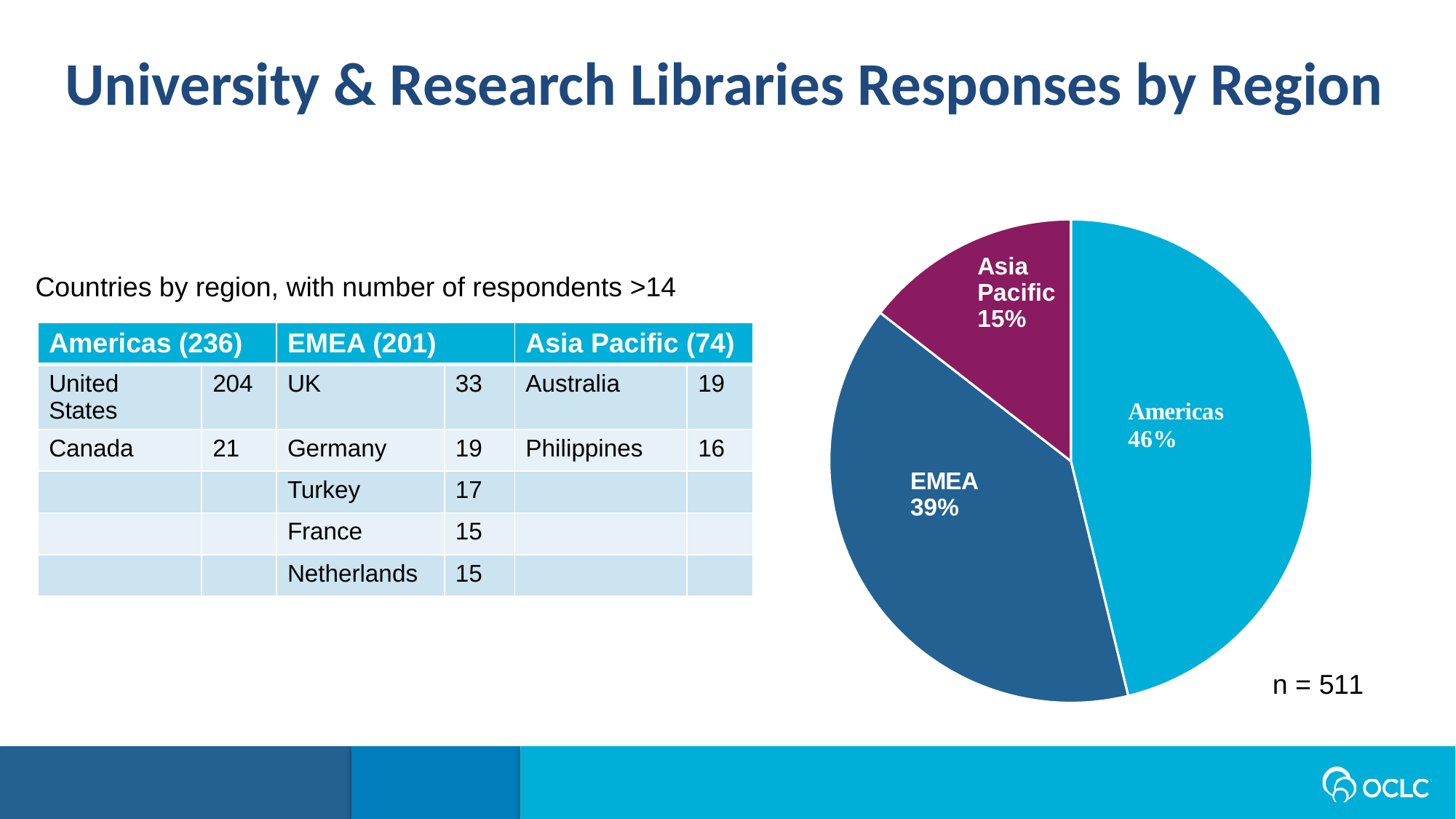
What kind of chart is shown on the slide? Pie chart What colour is the Asia Pacific slice in the pie chart? Purple Which slice is larger, EMEA or Asia Pacific? EMEA How many slices does the pie chart have? 3 What share of the pie chart does the EMEA slice represent? 39% What is the difference in percentage points between the Americas and EMEA slices? 7% What share of the pie chart does the Asia Pacific slice represent? 15% What is the difference in percentage points between the EMEA and Asia Pacific slices? 24% Which region has the smallest slice in the pie chart? Asia Pacific What is the total number of responses (n) shown next to the pie chart? n = 511 Which region has the largest slice in the pie chart? Americas What share of the pie chart does the Americas slice represent? 46%